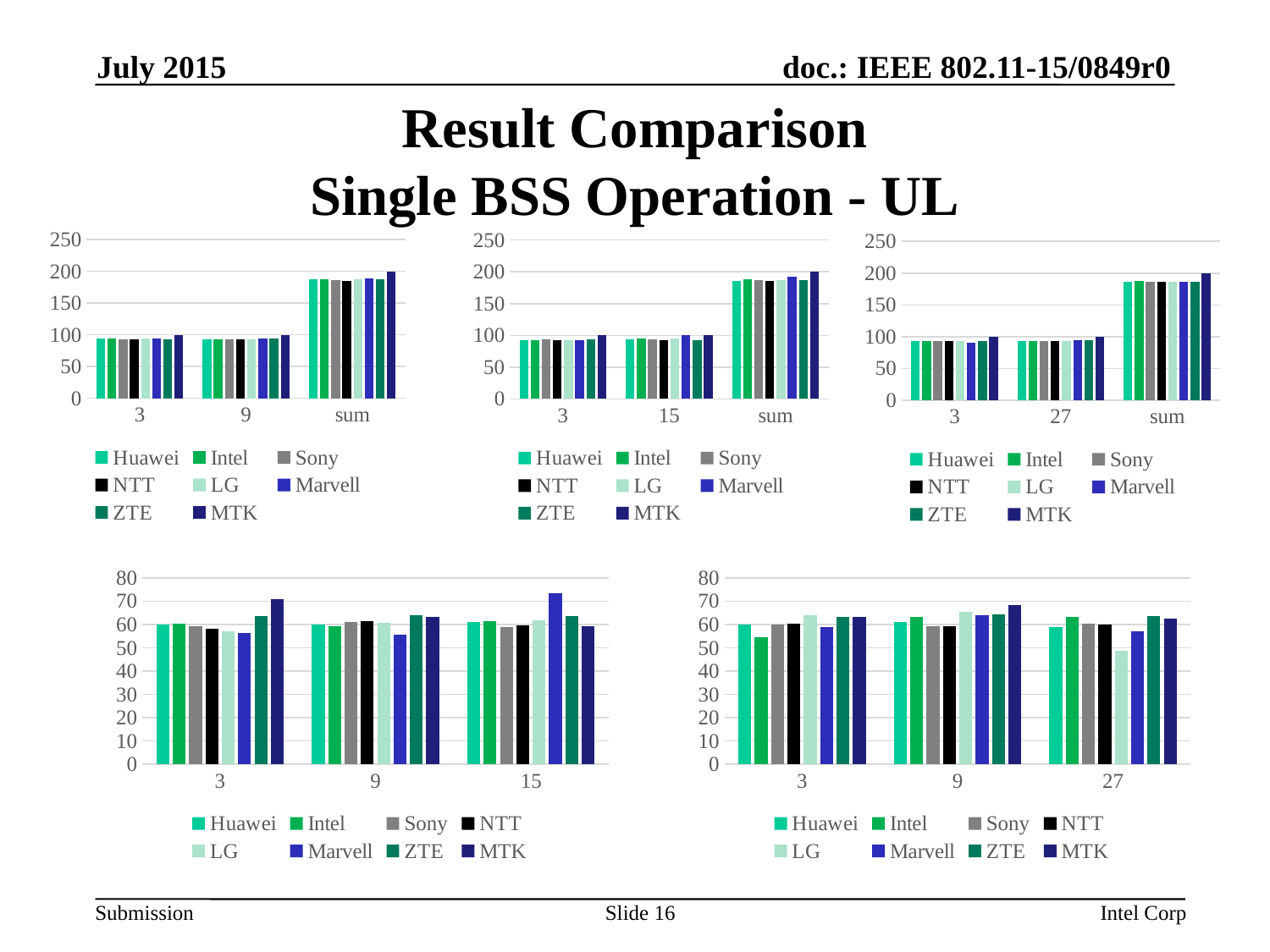
In the bottom-right chart, is the value for LG at category 27 greater or less than 60? less In the bottom-left chart, which series has the highest value at category 15? Marvell How many series does the legend of the top-left chart list? 8 What kind of chart is the top-left chart on the slide? bar chart In the bottom-left chart, which series has the lowest value at category 9? Marvell In the top-left chart, is the value for Huawei at category sum greater or less than 150? greater In the bottom-right chart, which series has the lowest value at category 27? LG In the top-right chart, is the value for Intel at category 27 greater or less than 150? less In the bottom-right chart, which is larger at category 3: the value for Intel or the value for MTK? MTK In the top-middle chart, which series has the highest value at category sum? MTK How many categories are shown on the x axis of the bottom-left chart? 3